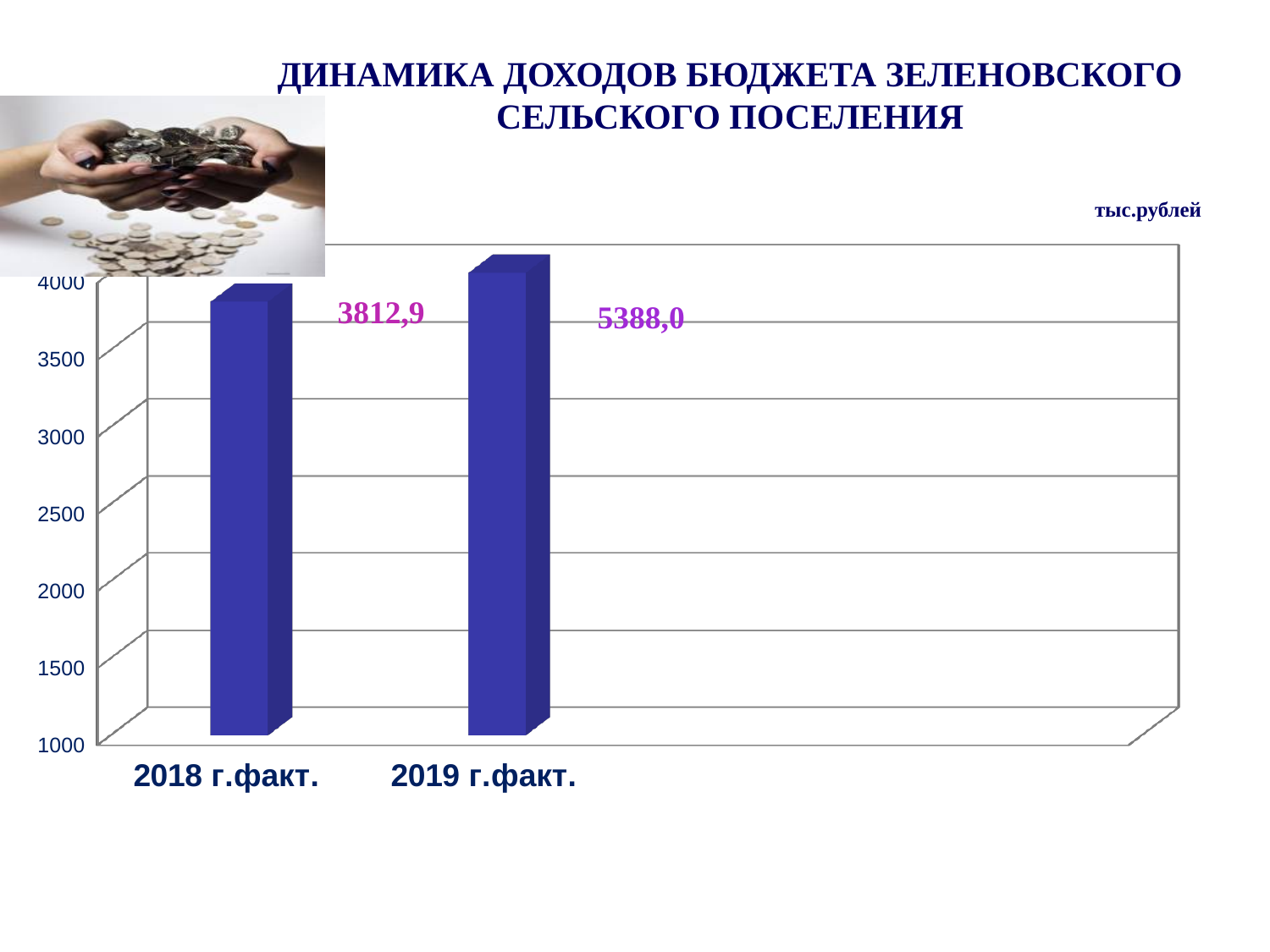
Which category has the lowest value? 2018 г.факт. Is the value for 2019 г.факт. greater or less than 4000? greater Do the values rise or fall from 2018 г.факт. to 2019 г.факт.? rise In what units are the values on the chart expressed? тыс.рублей What is the value for 2018 г.факт.? 3812,9 Is the value for 2018 г.факт. greater or less than 3500? greater What is the value for 2019 г.факт.? 5388,0 What is the difference between the values for 2019 г.факт. and 2018 г.факт.? 1575,1 Which is larger, the value for 2018 г.факт. or the value for 2019 г.факт.? 2019 г.факт. How many categories are shown on the chart? 2 What kind of chart is shown on the slide? bar chart Which category has the highest value? 2019 г.факт.